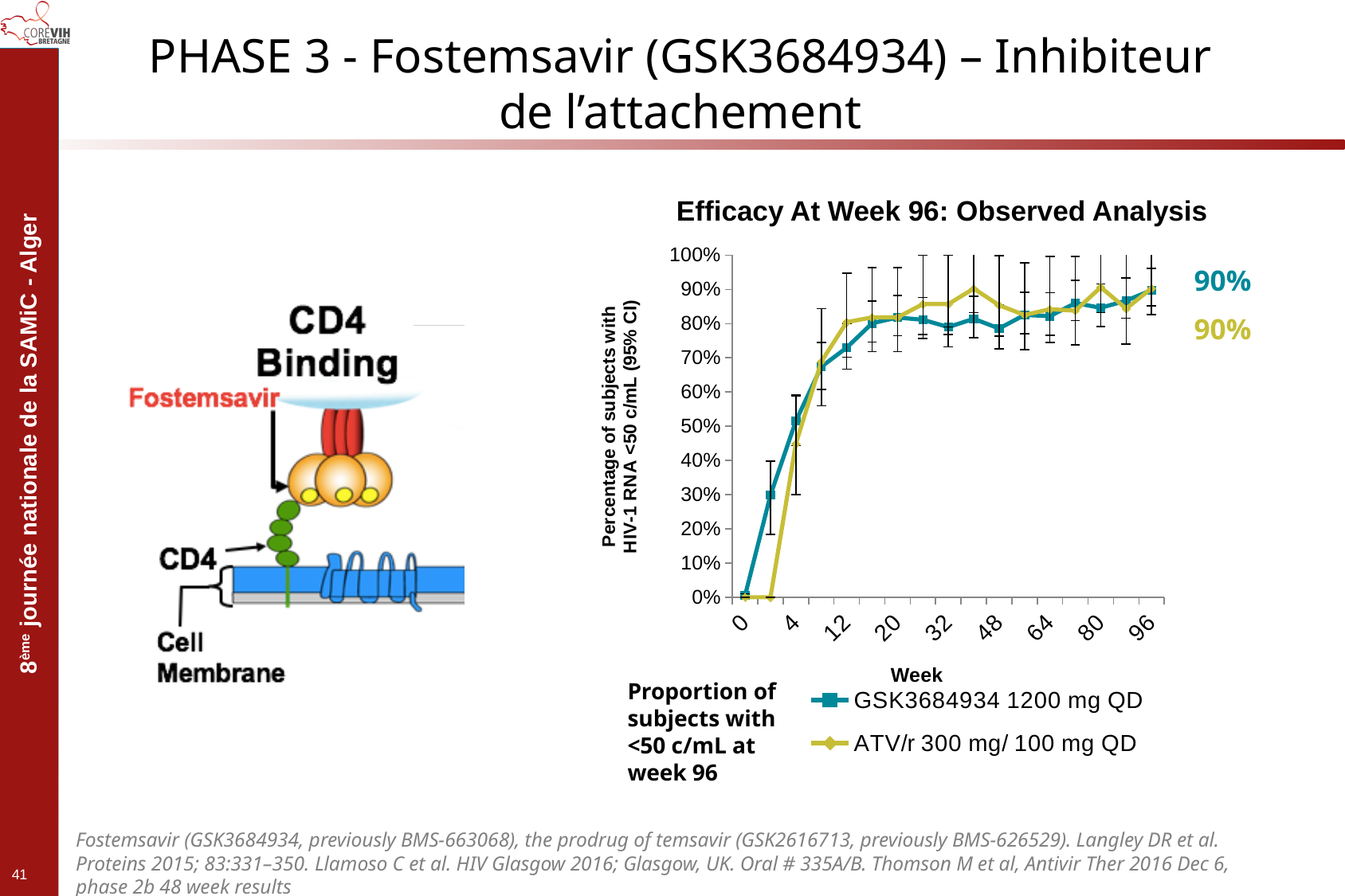
What is the difference between the GSK3684934 and ATV/r values at week 96? 0% How many series does the legend list? 2 What is the title of the chart? Efficacy At Week 96: Observed Analysis What is the label of the x axis? Week At week 4, which series has the larger value, GSK3684934 1200 mg QD or ATV/r 300 mg/ 100 mg QD? GSK3684934 1200 mg QD Is the value for GSK3684934 1200 mg QD at week 4 greater or less than 40%? greater How many week labels are shown on the x axis? 9 What is the value for ATV/r 300 mg/ 100 mg QD at week 96? 90% What is the value for GSK3684934 1200 mg QD at week 96? 90% Is the value for ATV/r 300 mg/ 100 mg QD at week 12 greater or less than 70%? greater Do the values for GSK3684934 1200 mg QD rise or fall from week 0 to week 96? rise What kind of chart is shown on the slide? line chart